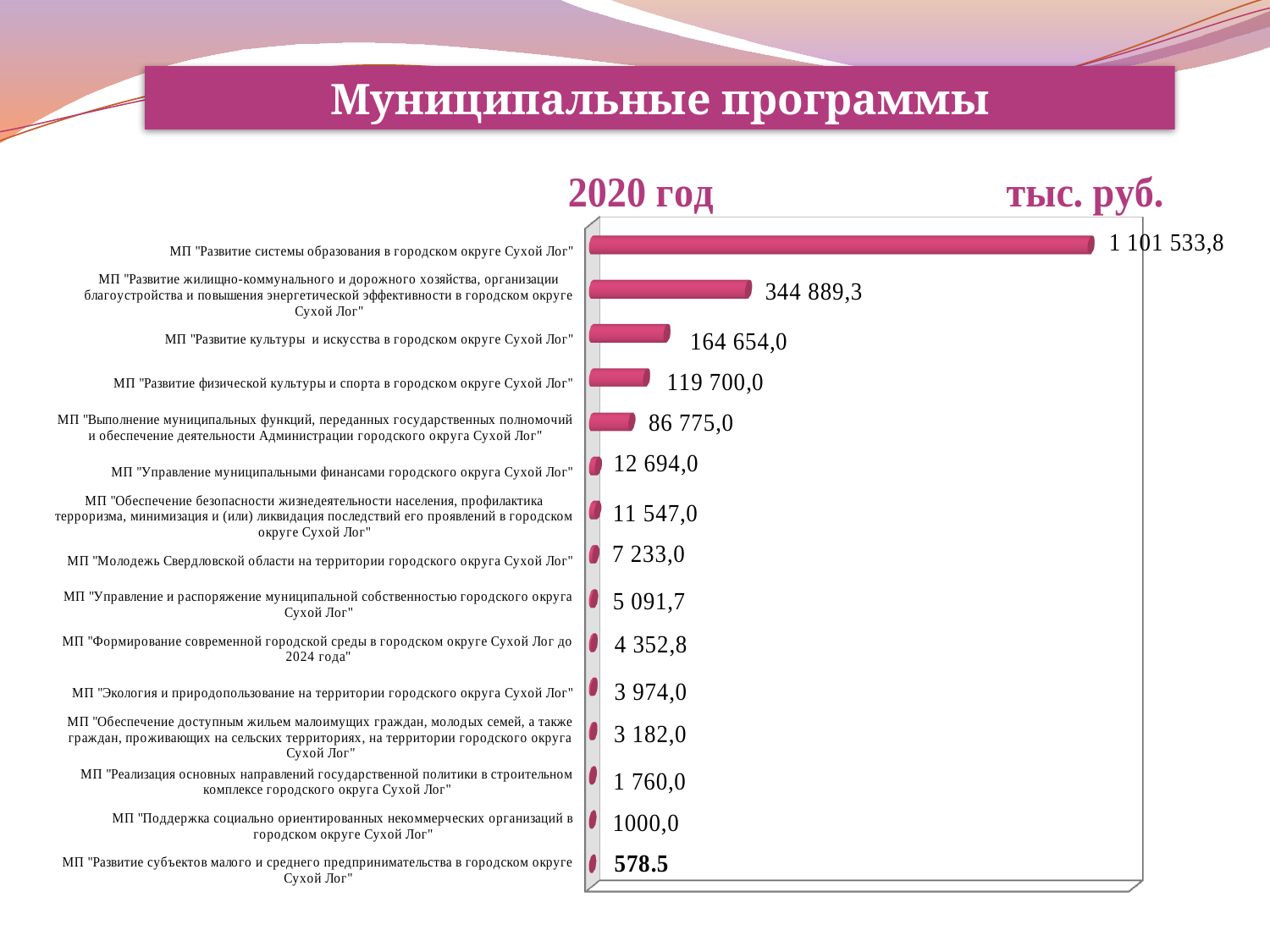
What is the value for МП "Развитие культуры и искусства в городском округе Сухой Лог"? 164 654,0 What is the value for МП "Поддержка социально ориентированных некоммерческих организаций в городском округе Сухой Лог"? 1000,0 Which programme has the highest value in the chart? МП "Развитие системы образования в городском округе Сухой Лог" Do the values increase or decrease going from the top bar to the bottom bar of the chart? Decrease What is the value for МП "Молодежь Свердловской области на территории городского округа Сухой Лог"? 7 233,0 What is the value for МП "Развитие системы образования в городском округе Сухой Лог"? 1 101 533,8 What is the difference between the values for МП "Развитие физической культуры и спорта" and МП "Выполнение муниципальных функций, переданных государственных полномочий и обеспечение деятельности Администрации"? 32 925,0 What type of chart is shown on the slide? Bar chart How many municipal programmes (categories) are plotted in the chart? 15 Which programme has the lowest value in the chart? МП "Развитие субъектов малого и среднего предпринимательства в городском округе Сухой Лог" Which is larger: the value for МП "Экология и природопользование" or the value for МП "Обеспечение доступным жильем малоимущих граждан, молодых семей"? МП "Экология и природопользование" In what units are the chart values expressed, according to the label above the chart? тыс. руб.